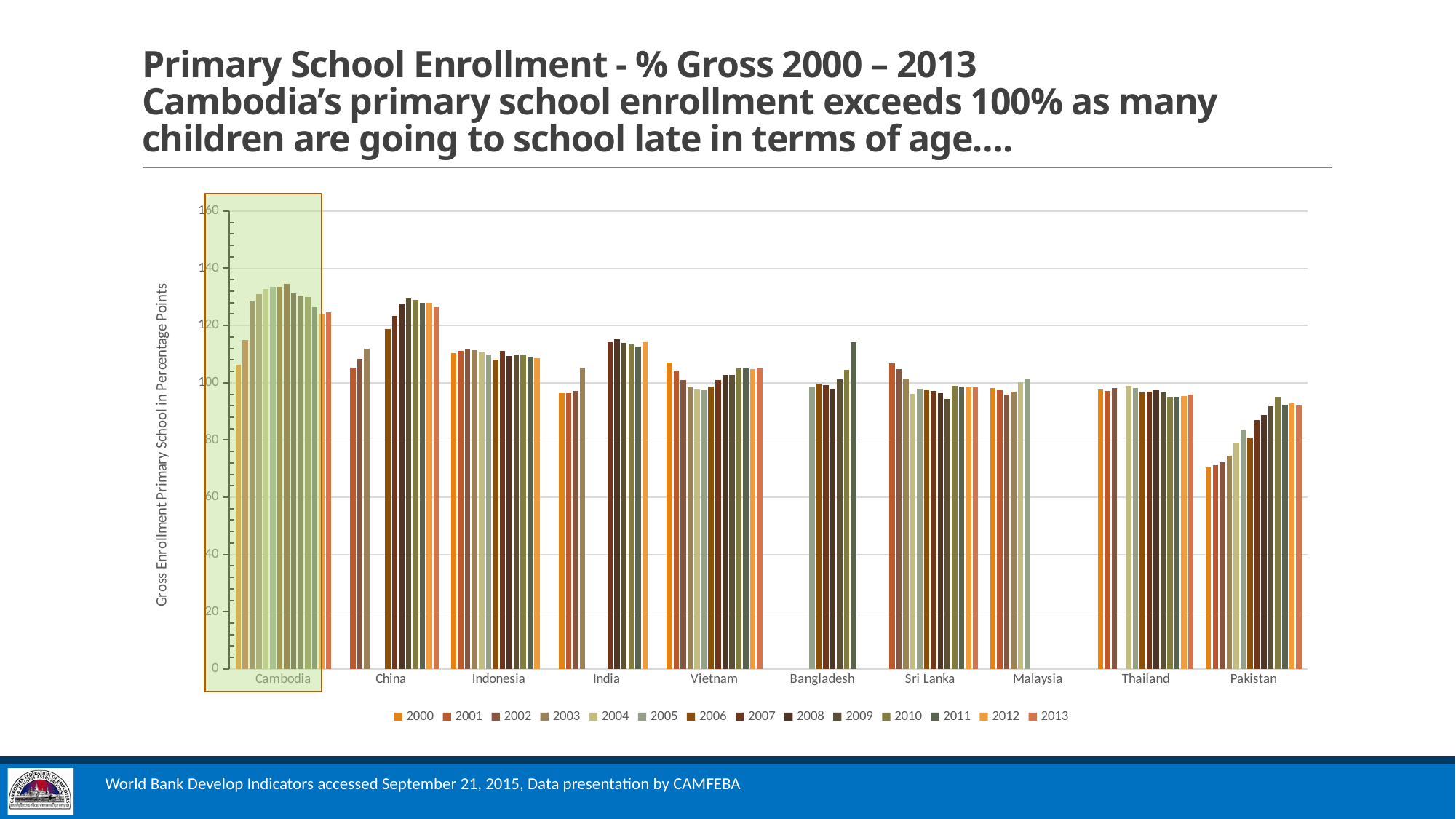
What kind of chart is shown on the slide? bar chart Which is larger, the 2000 value for Pakistan or the 2000 value for Thailand? Thailand Which country has the lowest bar in the chart? Pakistan Do Pakistan's values rise or fall from 2000 to 2013? rise How many series (years) does the legend list? 14 How many countries are shown on the x axis of the chart? 10 Is the value for Thailand in 2013 greater or less than 100? less Is the value for Bangladesh in 2011 greater or less than 100? greater What is the title of the y axis? Gross Enrollment Primary School in Percentage Points Is the value for Cambodia in 2000 greater or less than 100? greater Which country has the highest bar in the chart? Cambodia